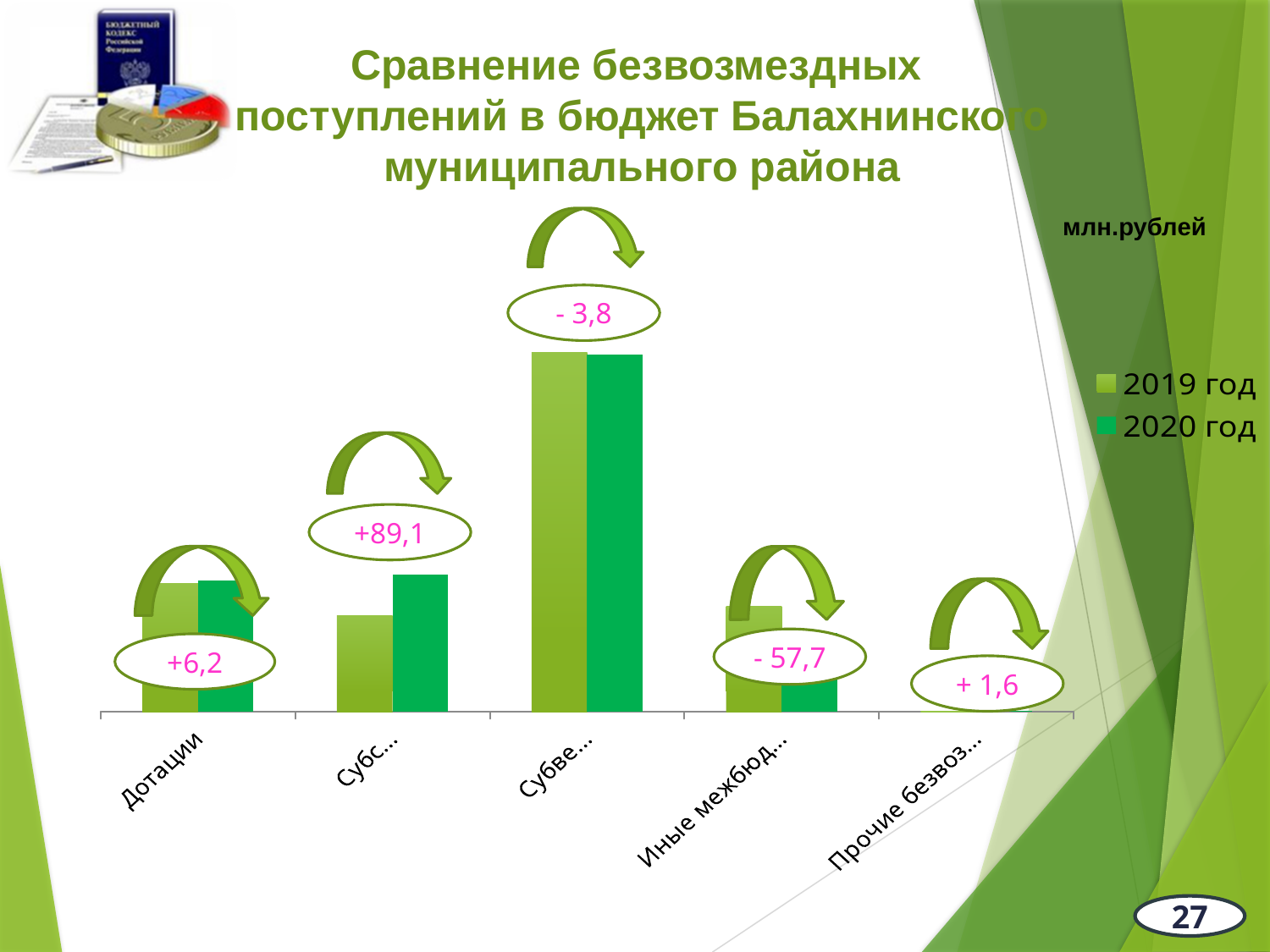
What unit of measurement is indicated for the chart? млн.рублей Which category has the smallest bars in the chart? Прочие безвоз… (the fifth category) What type of chart is shown on the slide? bar chart What change value is printed in the oval above the fourth category (Иные межбюд…)? - 57,7 How many series does the chart legend list? 2 How many categories are shown along the x axis of the chart? 5 Which category has the tallest bars in the chart? Субве… (the third category) For the fourth category (Иные межбюд…), which series has the taller bar, 2019 год or 2020 год? 2019 год What are the two entries in the chart legend? 2019 год, 2020 год What change value is printed in the oval above the second category (Субс…)? +89,1 What change value is printed in the oval above the Дотации bars? +6,2 For the second category (Субс…), which series has the taller bar, 2019 год or 2020 год? 2020 год